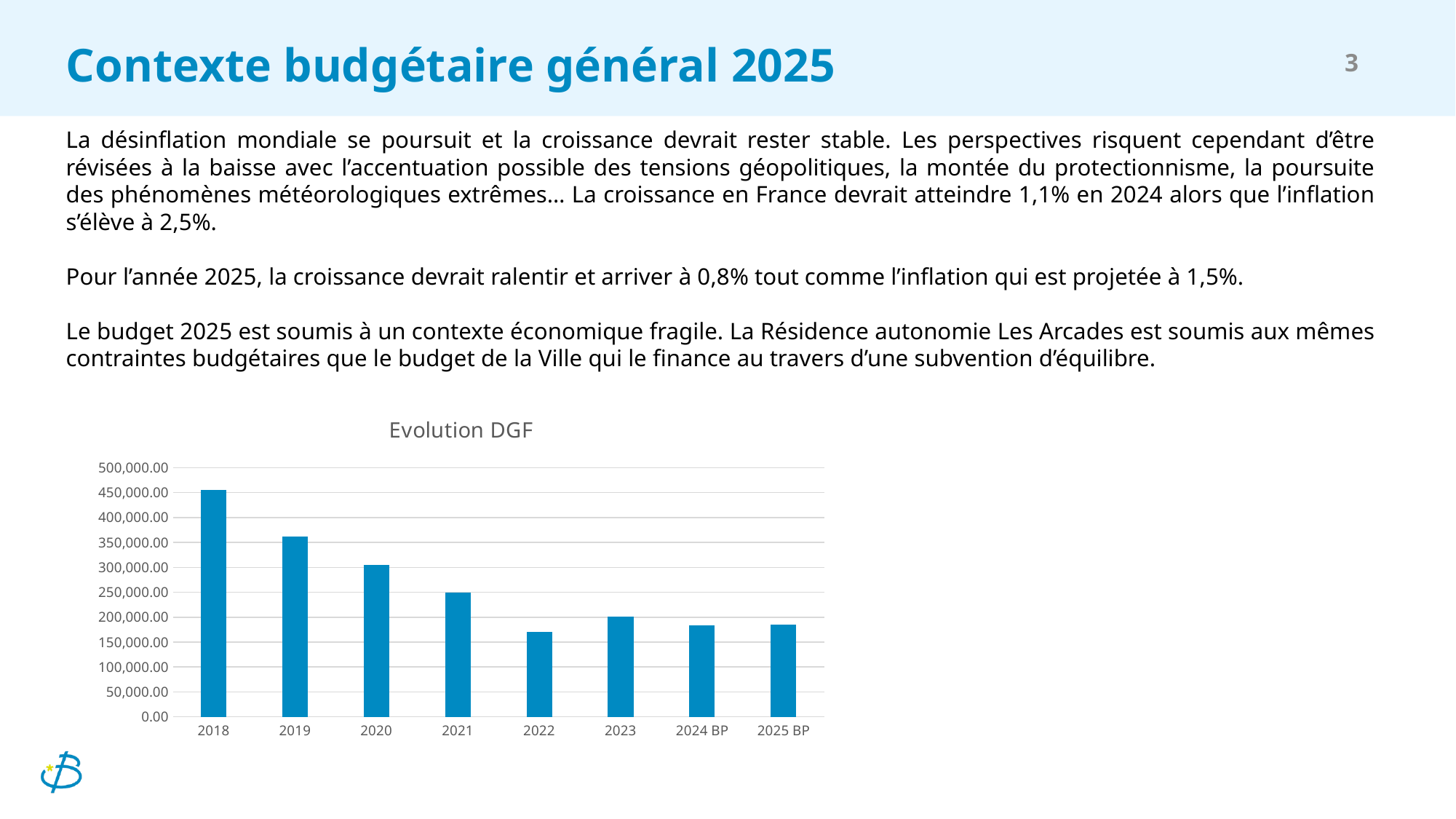
How many categories are shown on the x axis of the Evolution DGF chart? 8 What kind of chart is shown on the slide? bar chart Is the value for 2023 greater or less than 150,000.00? greater Do the values in the Evolution DGF chart rise or fall from 2018 to 2022? fall Is the value for 2018 greater or less than 400,000.00? greater Which year has the highest value in the Evolution DGF chart? 2018 Is the value for 2021 greater or less than 200,000.00? greater What is the title of the chart on the slide? Evolution DGF Which category has the lowest value in the Evolution DGF chart? 2022 Which is larger in the Evolution DGF chart, the value for 2019 or the value for 2020? 2019